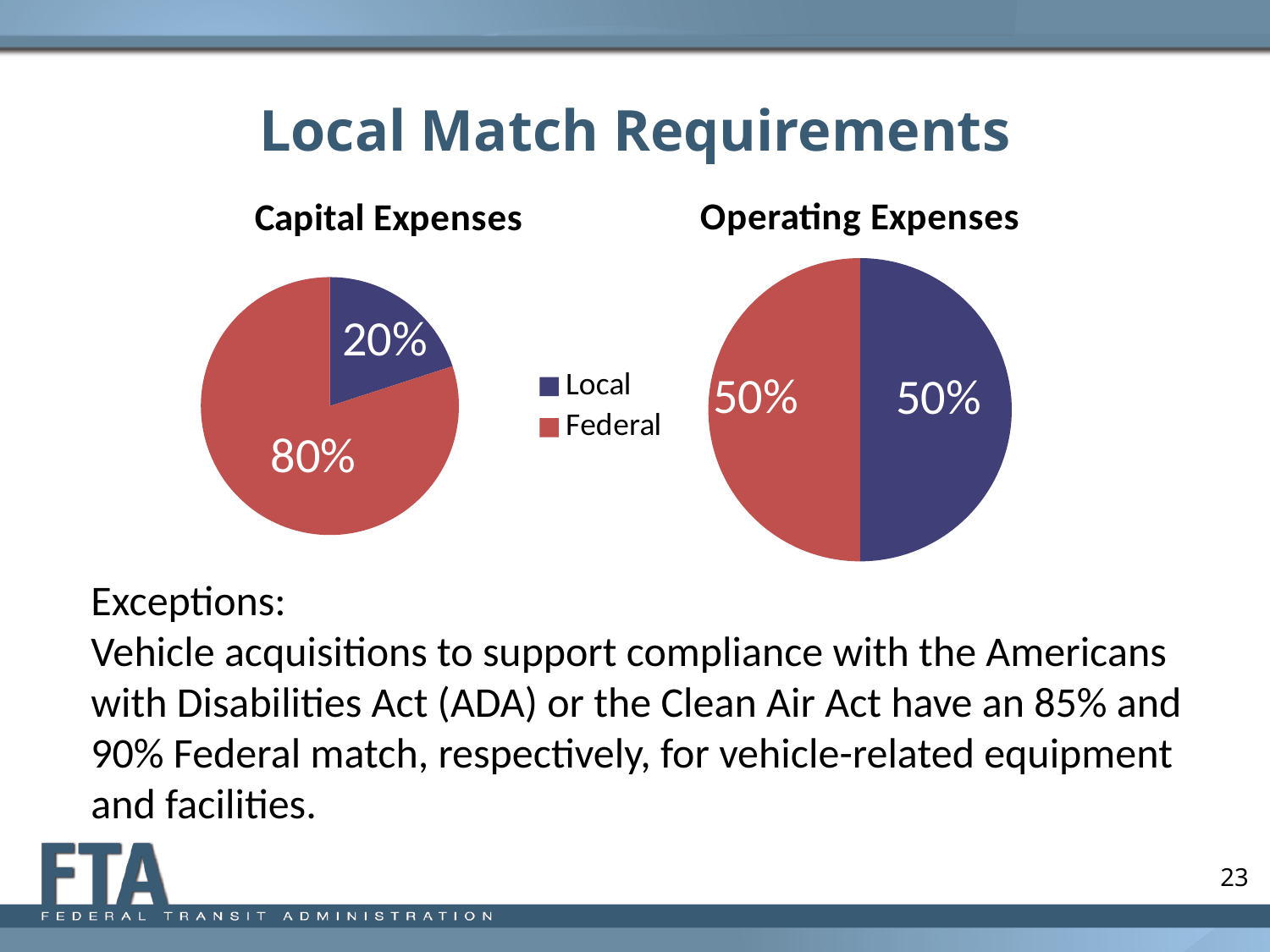
In the Operating Expenses chart, what share is Federal? 50% In the Capital Expenses chart, which slice is the largest? Federal What kind of chart is the Capital Expenses chart? Pie chart In the Capital Expenses chart, what share is Local? 20% In the Capital Expenses chart, what is the difference between the Federal and Local shares? 60% In the Capital Expenses chart, which is larger, the Local share or the Federal share? Federal In the Capital Expenses chart, what share is Federal? 80% Which colour represents Federal in the legend? Red In the Capital Expenses chart, which slice is the smallest? Local How many entries does the legend list? 2 How many slices does the Operating Expenses chart have? 2 In the Operating Expenses chart, what share is Local? 50%